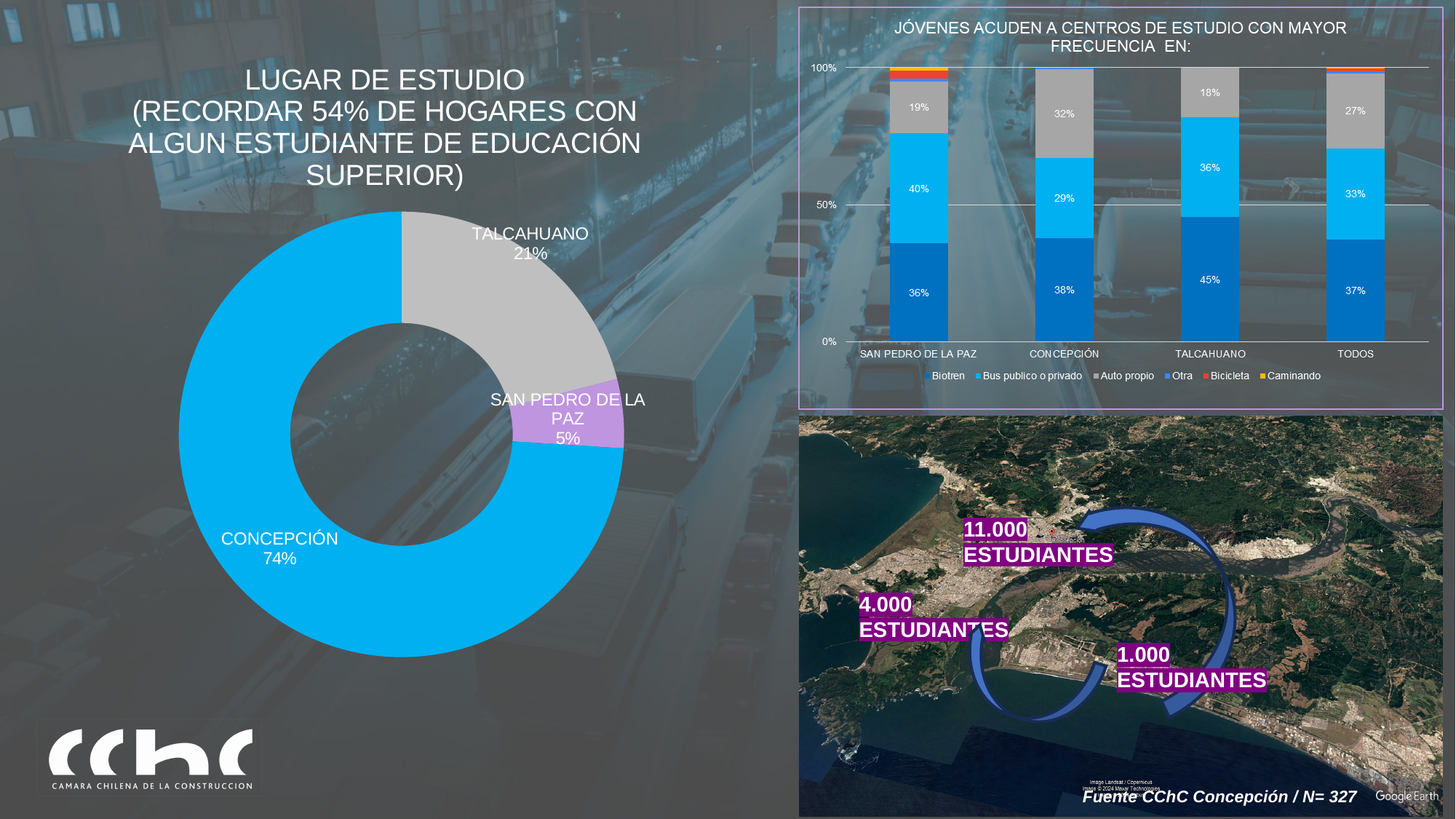
In the donut chart on the left, what share of students study in Concepción? 74% In the donut chart on the left, what is the difference between the shares of Concepción and Talcahuano? 53% In the donut chart on the left, what share is shown for Talcahuano? 21% In the stacked bar chart on the right, what is the Auto propio value for Concepción? 32% What kind of chart is the one on the right of the slide? Stacked bar chart In the stacked bar chart on the right, what is the Bus publico o privado value for San Pedro de la Paz? 40% In the donut chart on the left, which place has the smallest share? San Pedro de la Paz In the stacked bar chart on the right, is the Auto propio value larger for Concepción or for Talcahuano? Concepción In the stacked bar chart on the right, how many series does the legend list? 6 In the stacked bar chart on the right, which category has the highest Biotren value? Talcahuano In the stacked bar chart on the right, what is the Biotren value for Talcahuano? 45% In the donut chart on the left, how many categories are shown? 3